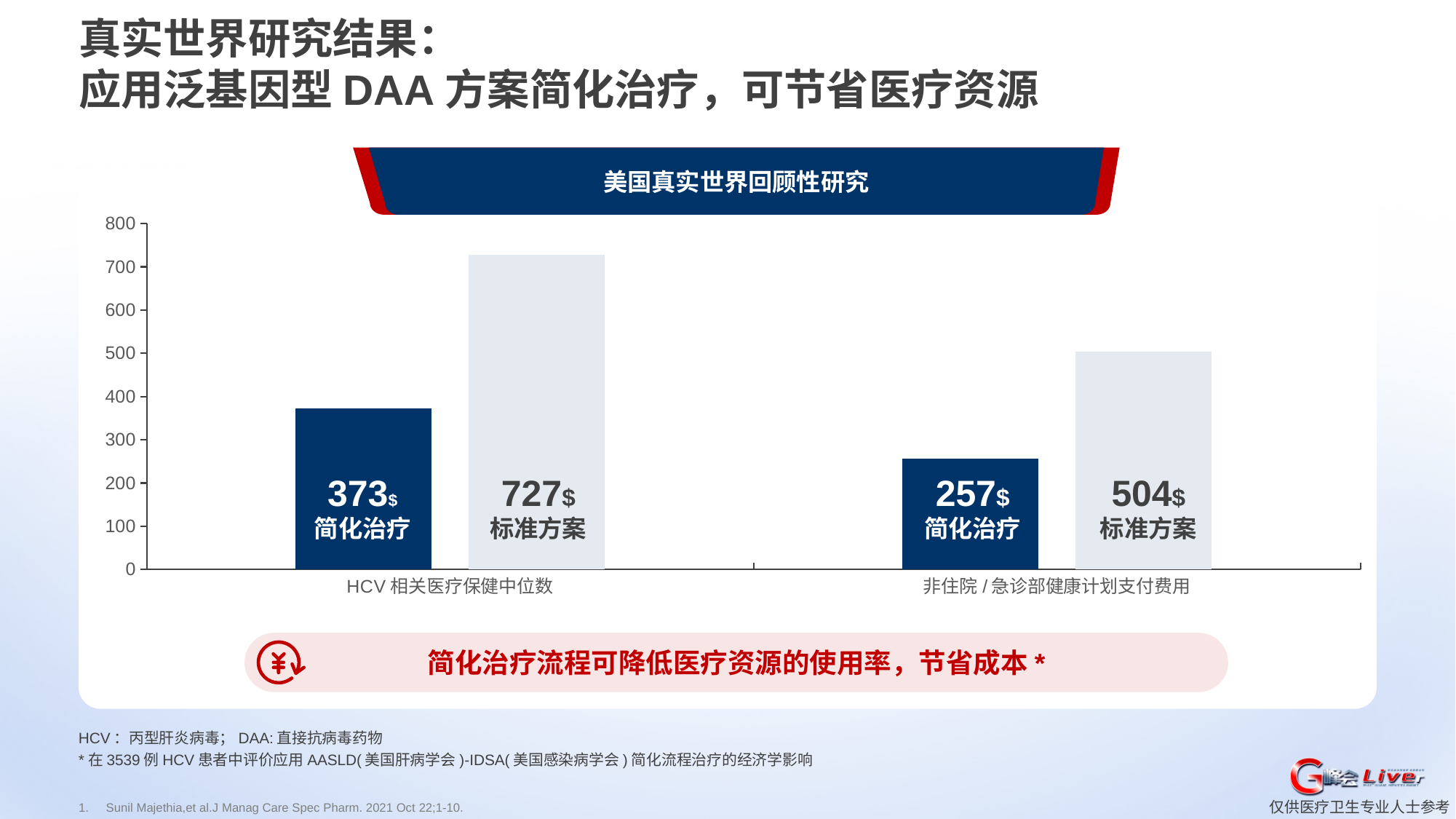
What is the value for 简化治疗 in the HCV 相关医疗保健中位数 category? 373$ Which bar has the highest value in the chart? 标准方案 in HCV 相关医疗保健中位数 (727$) What is the difference between 标准方案 and 简化治疗 in the HCV 相关医疗保健中位数 category? 354$ Is the value for 简化治疗 in the HCV 相关医疗保健中位数 category greater or less than 400? less How many categories are shown on the x axis of the chart? 2 What kind of chart is shown on the slide? bar chart What is the difference between 标准方案 and 简化治疗 in the 非住院 / 急诊部健康计划支付费用 category? 247$ What is the value for 简化治疗 in the 非住院 / 急诊部健康计划支付费用 category? 257$ Which bar has the lowest value in the chart? 简化治疗 in 非住院 / 急诊部健康计划支付费用 (257$) What is the value for 标准方案 in the 非住院 / 急诊部健康计划支付费用 category? 504$ In the 非住院 / 急诊部健康计划支付费用 category, which is larger, 简化治疗 or 标准方案? 标准方案 What is the value for 标准方案 in the HCV 相关医疗保健中位数 category? 727$